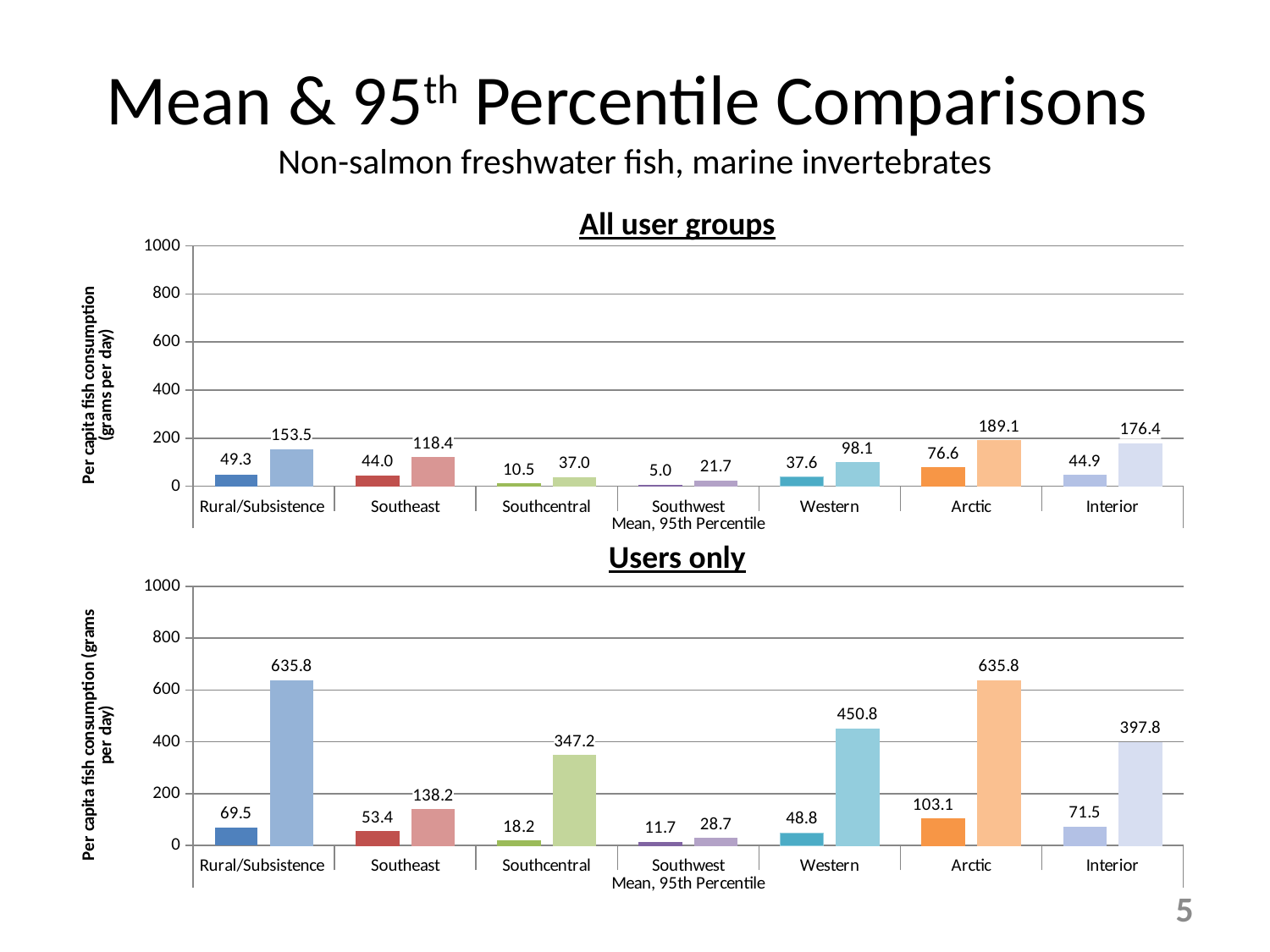
In the 'All user groups' chart, which region has the highest 95th percentile value? Arctic In the 'All user groups' chart, which region has the lowest mean value? Southwest In the 'All user groups' chart, which is larger, the mean for Rural/Subsistence or the mean for Southeast? Rural/Subsistence What kind of chart is the 'All user groups' chart? Bar chart In the 'Users only' chart, is the 95th percentile value for Interior greater or less than 400? less In the 'Users only' chart, what is the difference between the 95th percentile and mean values for Southcentral? 329.0 In the 'Users only' chart, which region has the lowest 95th percentile value? Southwest In the 'All user groups' chart, what is the mean value for Arctic? 76.6 In the 'Users only' chart, what is the mean value for Southwest? 11.7 In the 'Users only' chart, what is the 95th percentile value for Western? 450.8 How many regions are shown on the x axis of the 'Users only' chart? 7 In the 'All user groups' chart, what is the 95th percentile value for Interior? 176.4